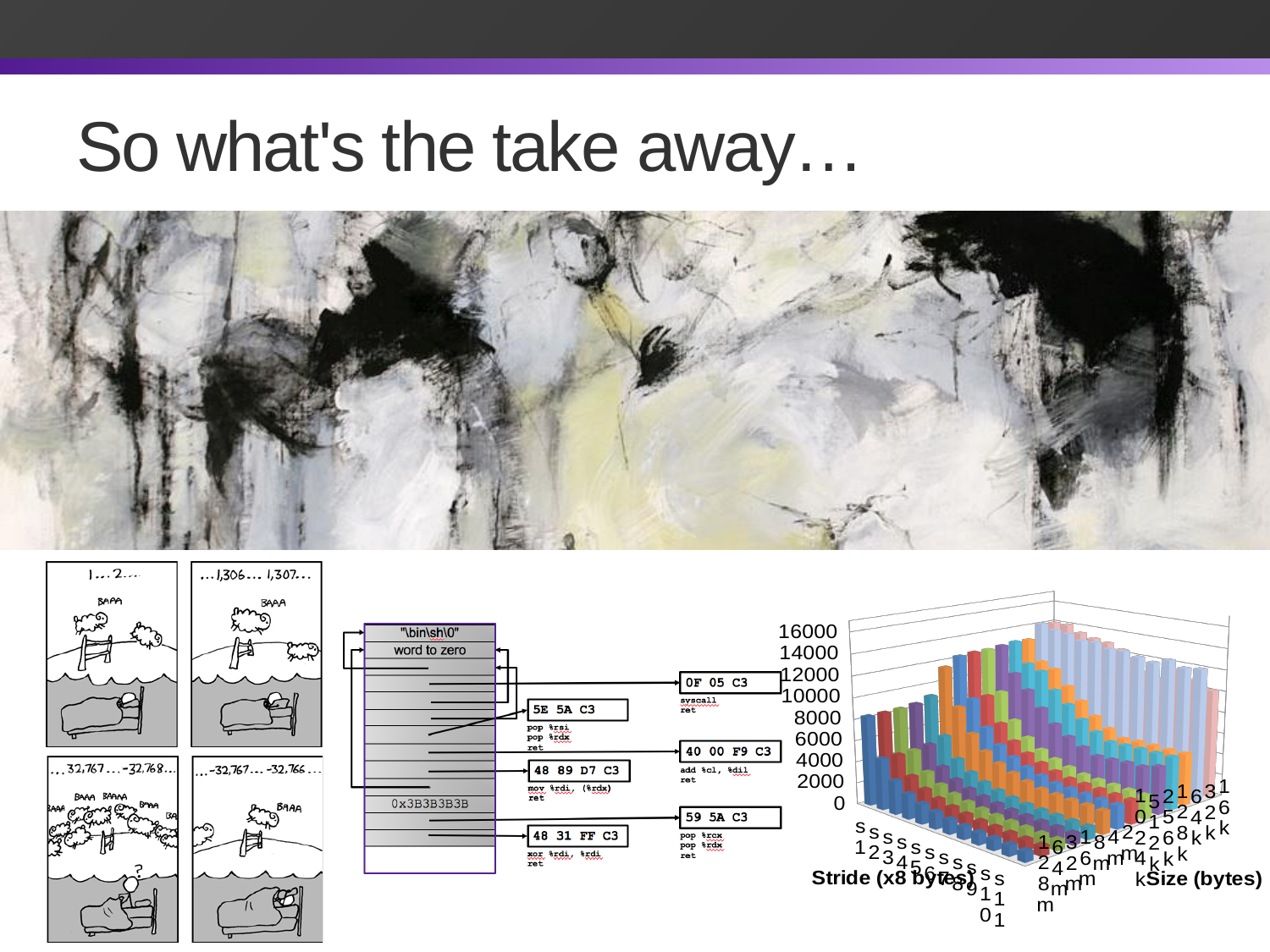
What is the label on the horizontal axis at the front of the bottom-right chart? Stride (x8 bytes) What is the lowest value shown on the vertical axis of the bottom-right chart? 0 What is the label on the depth axis on the right side of the bottom-right chart? Size (bytes) What is the interval between consecutive tick marks on the vertical axis of the bottom-right chart? 2000 What is the highest value shown on the vertical axis of the bottom-right chart? 16000 What kind of chart is shown in the bottom right of the slide? bar chart